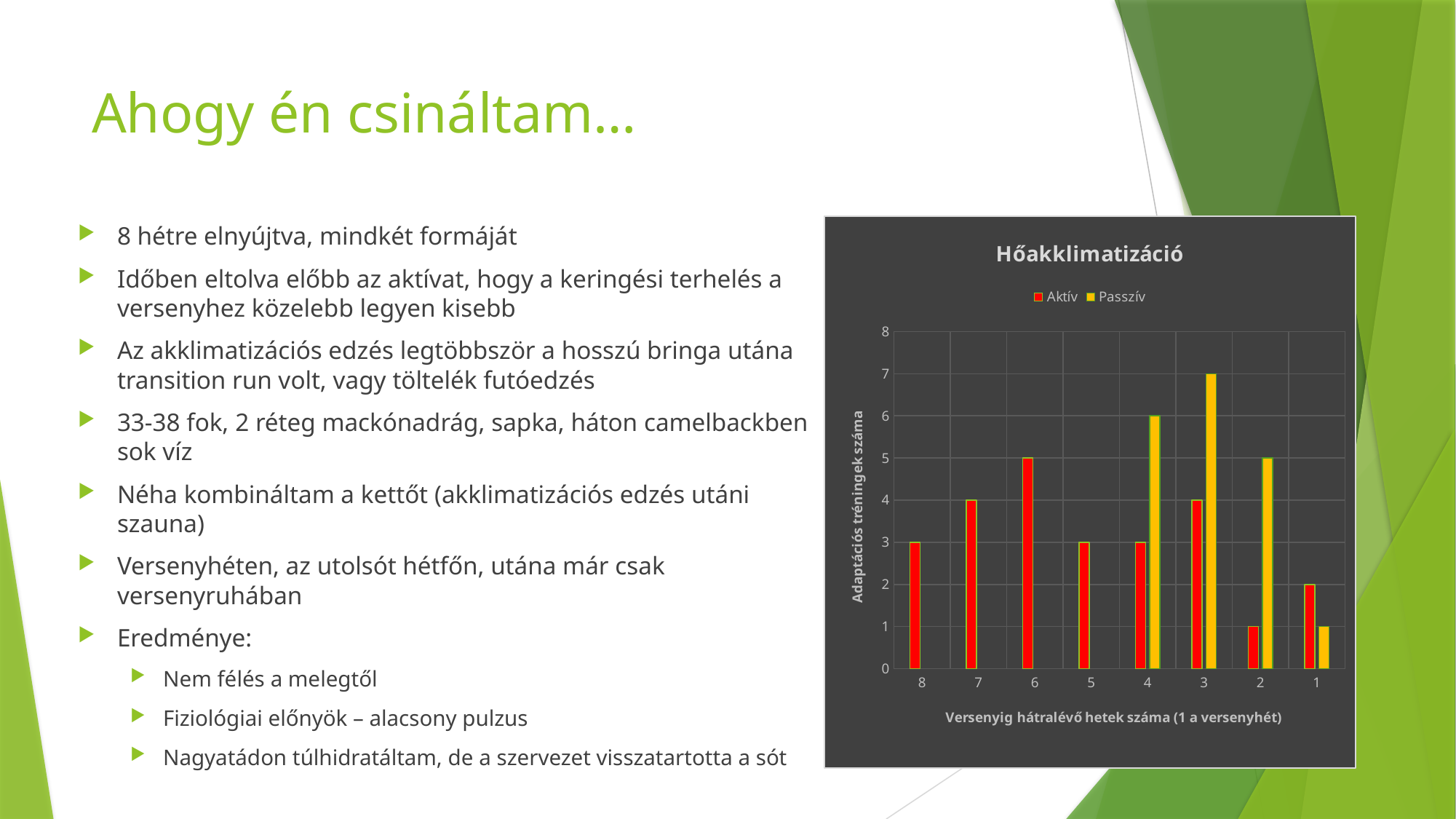
How many categories are shown on the x axis of the chart? 8 At which week is the Aktív value lowest? 2 At which week is the Passzív value highest? 3 How many series does the chart's legend list? 2 What kind of chart is shown on the slide? bar chart What is the Aktív value at week 6? 5 What is the Passzív value at week 3? 7 Which colour represents the Passzív series in the chart? yellow What is the difference between the Passzív and Aktív values at week 4? 3 What is the title of the chart? Hőakklimatizáció What is the Aktív value at week 2? 1 At week 1, which series has the larger value, Aktív or Passzív? Aktív